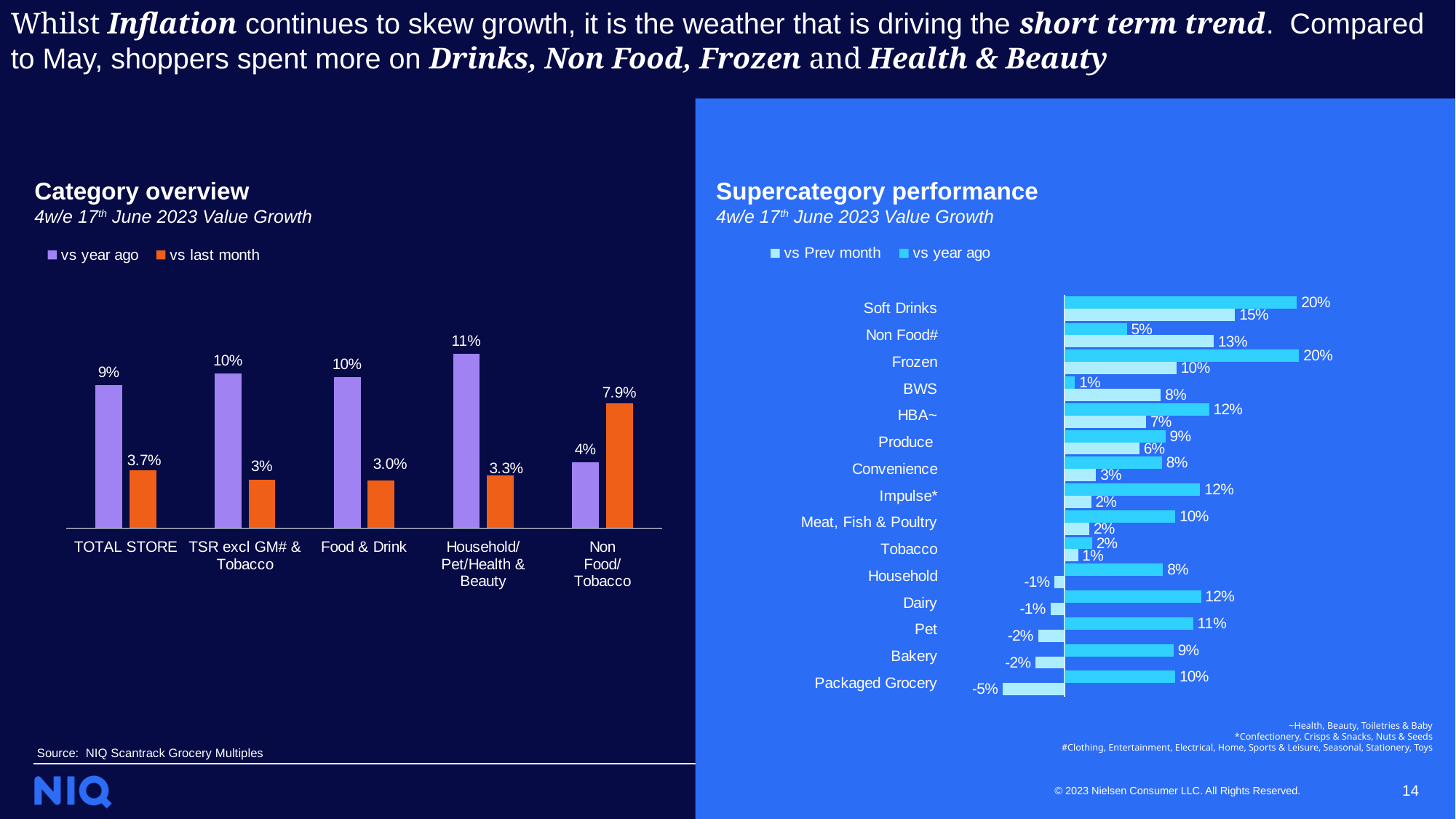
In the Category overview chart, which category has the lowest vs year ago value? Non Food/Tobacco In the Category overview chart, what is the vs last month value for Non Food/Tobacco? 7.9% How many supercategories are listed in the Supercategory performance chart? 15 In the Category overview chart, which has the larger vs last month value: Food & Drink or Household/Pet/Health & Beauty? Household/Pet/Health & Beauty In the Category overview chart, what is the vs year ago value for TOTAL STORE? 9% In the Supercategory performance chart, what are the two values shown for Frozen? 20% and 10% How many categories are shown in the Category overview chart? 5 In the Category overview chart, which category has the highest vs year ago value? Household/Pet/Health & Beauty What kind of chart is the Supercategory performance chart? Bar chart How many series does the legend of the Category overview chart list? 2 In the Supercategory performance chart, which supercategory has the lowest value shown? Packaged Grocery In the Category overview chart, what is the difference between the vs year ago and vs last month values for TOTAL STORE? 5.3 percentage points